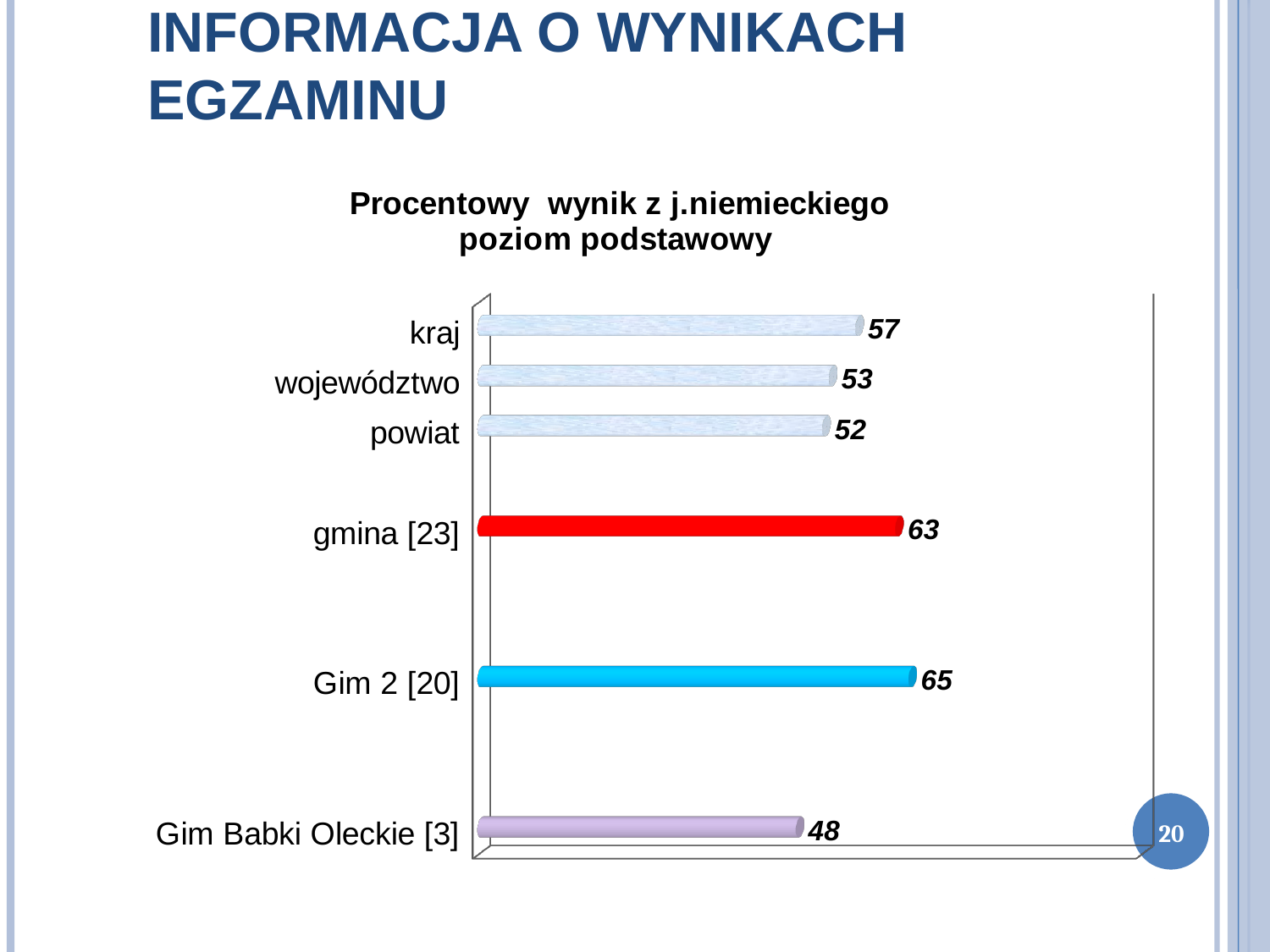
What is the value for gmina [23]? 63 How many categories are shown in the chart? 6 Which category has the lowest value? Gim Babki Oleckie [3] What is the difference between the values for kraj and powiat? 5 What is the value for Gim Babki Oleckie [3]? 48 What is the value for kraj? 57 Which category has the highest value? Gim 2 [20] What is the title of the chart? Procentowy wynik z j.niemieckiego poziom podstawowy What is the value for Gim 2 [20]? 65 What kind of chart is shown on the slide? bar chart What is the difference between the values for Gim 2 [20] and Gim Babki Oleckie [3]? 17 Which is larger, the value for gmina [23] or the value for województwo? gmina [23]